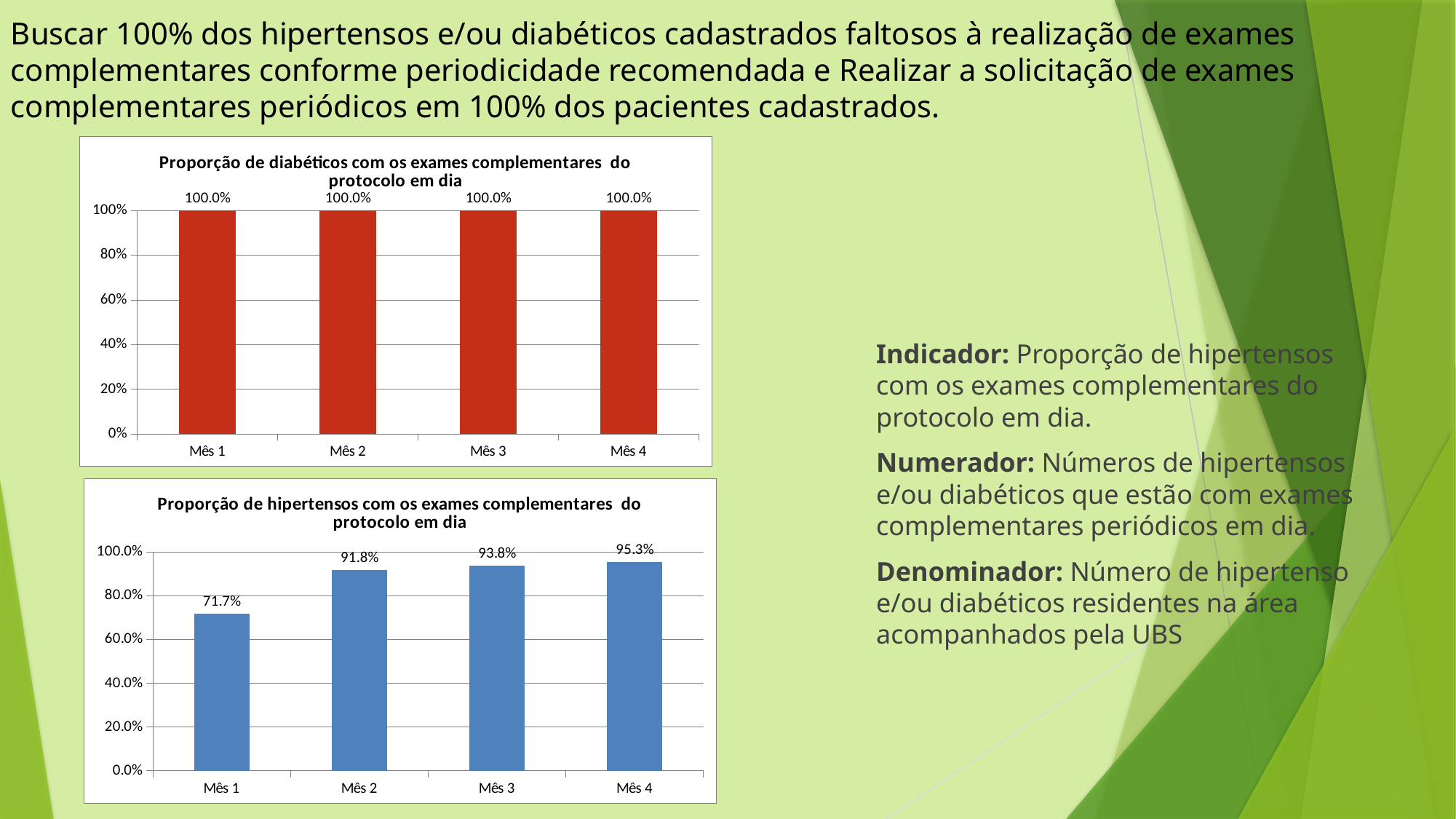
In the bottom chart (Proporção de hipertensos com os exames complementares do protocolo em dia), what is the value for Mês 4? 95.3% In the bottom chart (Proporção de hipertensos com os exames complementares do protocolo em dia), what is the difference between the values for Mês 4 and Mês 1? 23.6% In the bottom chart (Proporção de hipertensos com os exames complementares do protocolo em dia), what is the value for Mês 1? 71.7% In the bottom chart (Proporção de hipertensos com os exames complementares do protocolo em dia), which month has the highest value? Mês 4 In the bottom chart (Proporção de hipertensos com os exames complementares do protocolo em dia), do the values rise or fall from Mês 1 to Mês 4? rise How many months are shown on the x axis of the top chart (Proporção de diabéticos com os exames complementares do protocolo em dia)? 4 What kind of chart is the bottom chart (Proporção de hipertensos com os exames complementares do protocolo em dia)? bar chart In the bottom chart (Proporção de hipertensos com os exames complementares do protocolo em dia), which month has the lowest value? Mês 1 What colour are the bars in the top chart (Proporção de diabéticos com os exames complementares do protocolo em dia)? red In the top chart (Proporção de diabéticos com os exames complementares do protocolo em dia), what is the value for Mês 3? 100.0% In the bottom chart (Proporção de hipertensos com os exames complementares do protocolo em dia), is the value for Mês 1 greater or less than 80.0%? less In the bottom chart (Proporção de hipertensos com os exames complementares do protocolo em dia), which is larger, the value for Mês 2 or Mês 1? Mês 2